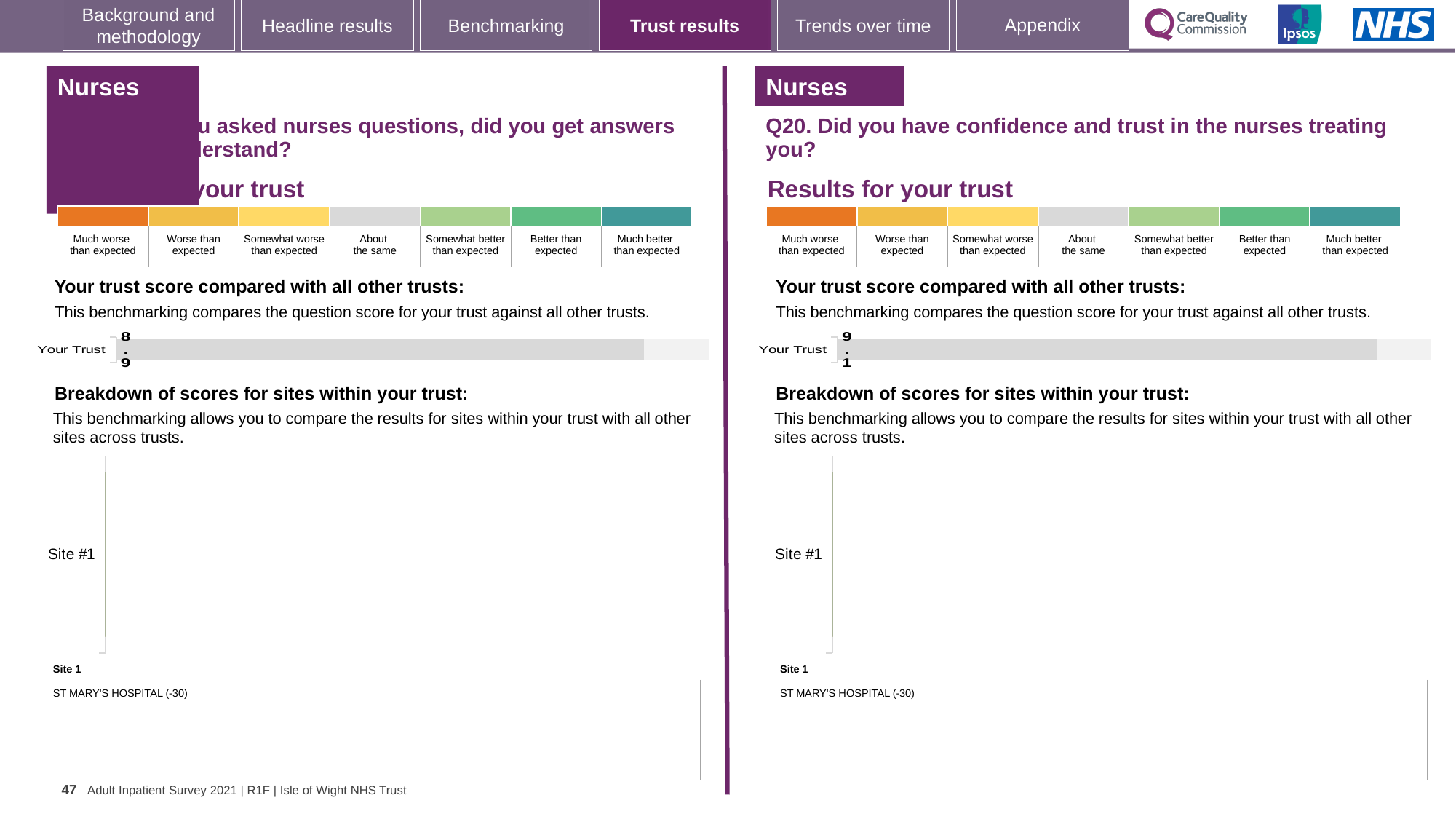
How many categories are plotted on the left-hand 'Your trust score compared with all other trusts' chart? 1 What is the difference between the Your Trust score on the right-hand chart (Q20) and the Your Trust score on the left-hand chart? 0.2 On the left-hand 'Your trust score compared with all other trusts' chart, what is the value shown for Your Trust? 8.9 What is the label of the single category on the right-hand 'Your trust score compared with all other trusts' chart (Q20)? Your Trust How many sites are listed in the right-hand 'Breakdown of scores for sites within your trust' chart (Q20)? 1 What kind of chart is used to show the Your Trust score on the left-hand side of the slide? Bar chart How many colour bands are shown in the 'Results for your trust' scale on the right-hand side of the slide (Q20)? 7 Which is larger: the Your Trust score on the left-hand chart or the Your Trust score on the right-hand chart (Q20)? The right-hand chart (Q20), 9.1 On the right-hand 'Your trust score compared with all other trusts' chart (Q20), what is the value shown for Your Trust? 9.1